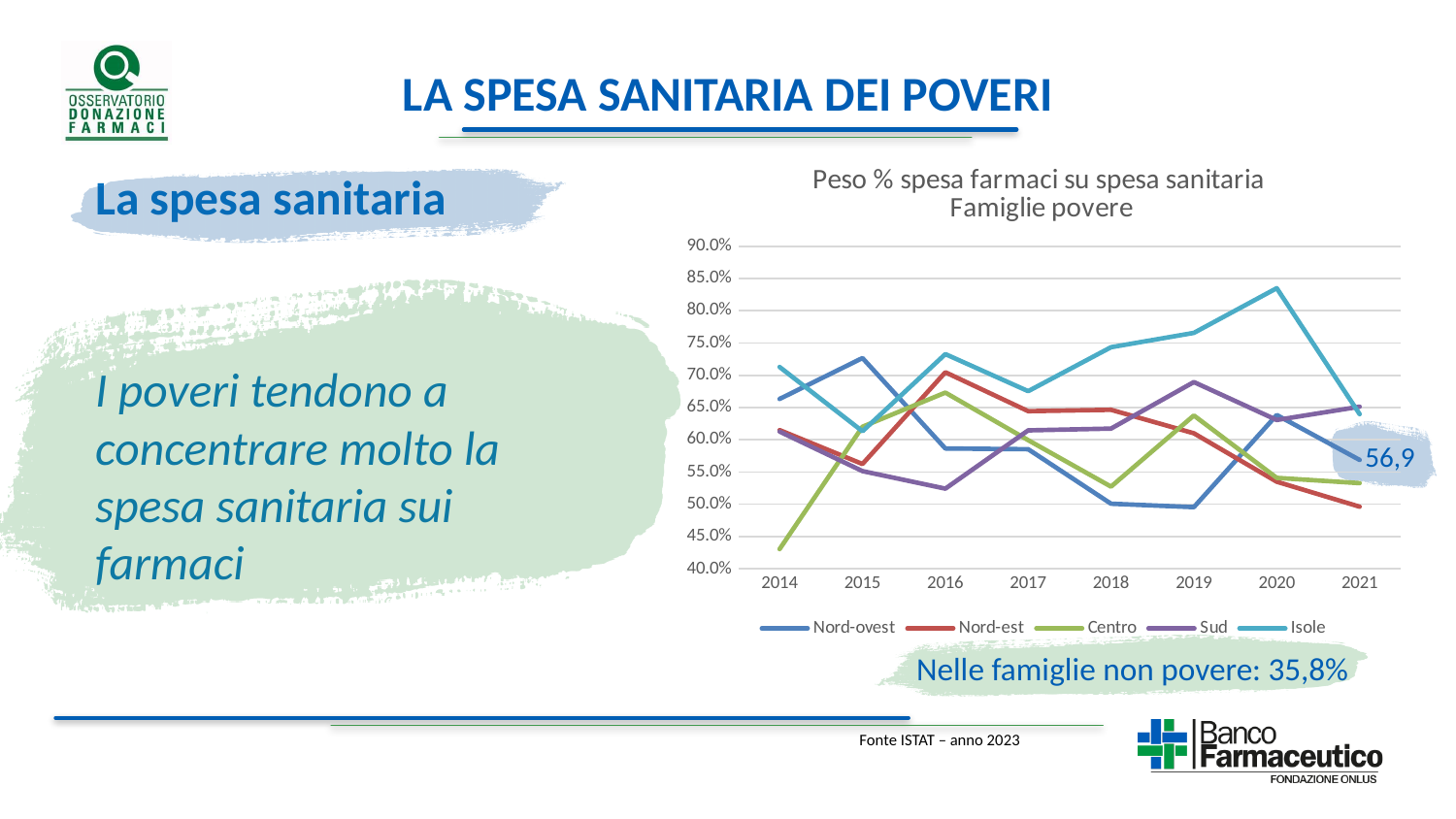
Which series has the lowest value in 2014? Centro Is the value for Nord-ovest in 2015 greater or less than 70.0%? greater Which series has the highest value in 2020? Isole Is the value for Isole in 2020 greater or less than 80.0%? greater Which series has the lowest value in 2019? Nord-ovest Does the Nord-est series rise or fall from 2016 to 2021? fall What type of chart is shown on the slide? line chart How many years are shown on the x axis of the chart? 8 In 2016, which series has the larger value, Centro or Sud? Centro How many series does the legend of the chart list? 5 Is the value for Centro in 2014 greater or less than 45.0%? less What is the labelled value for Nord-ovest in 2021? 56,9